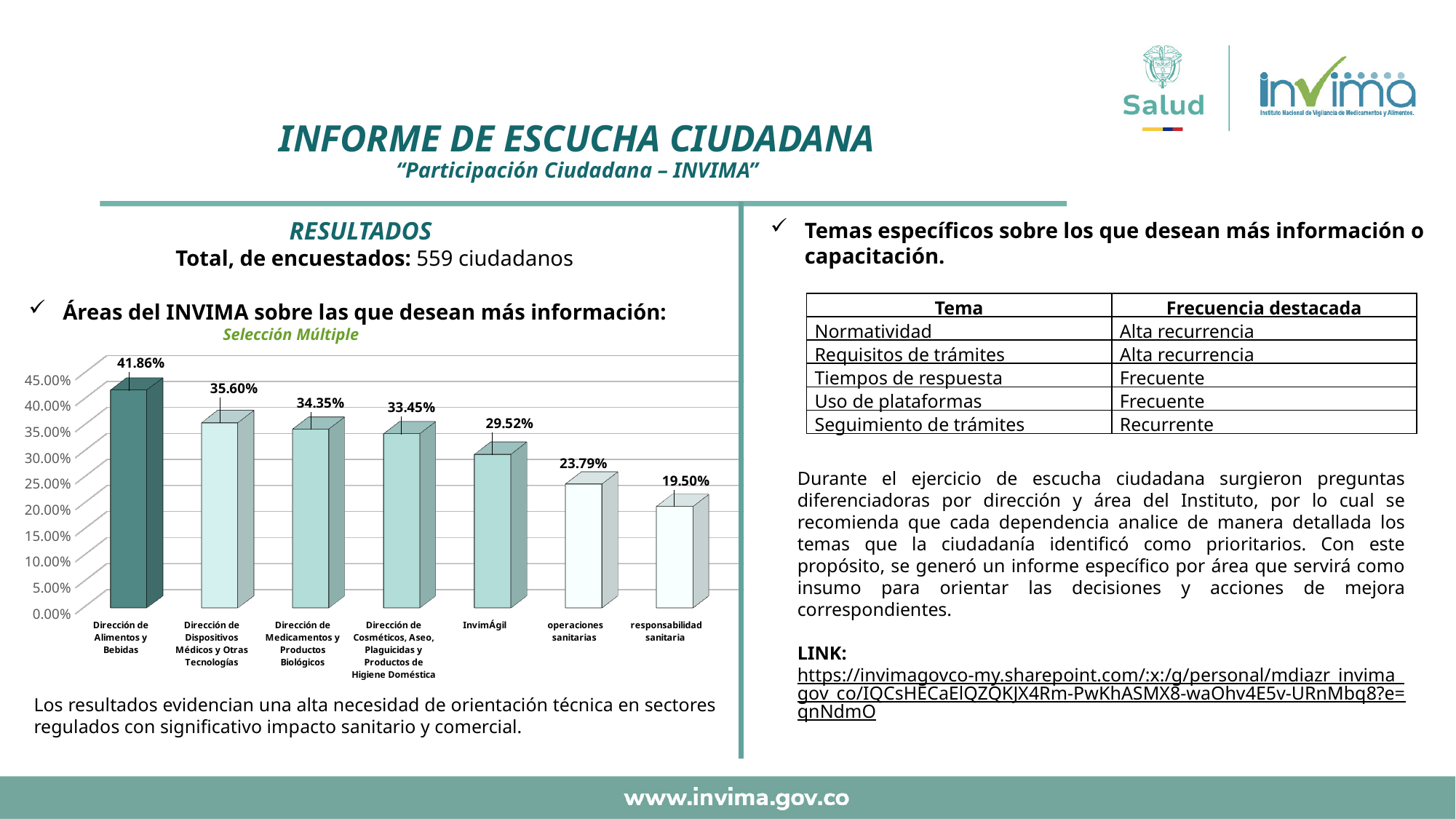
What is the value for operaciones sanitarias? 23.79% Do the values rise or fall from left to right along the x axis? Fall What is the value for Dirección de Cosméticos, Aseo, Plaguicidas y Productos de Higiene Doméstica? 33.45% Which category has the lowest value? responsabilidad sanitaria What kind of chart is shown on the slide? Bar chart What is the value for InvimÁgil? 29.52% Which category has the highest value? Dirección de Alimentos y Bebidas What is the value for Dirección de Alimentos y Bebidas? 41.86% How many categories are shown in the chart? 7 What is the difference between the values for InvimÁgil and operaciones sanitarias? 5.73% What is the difference between the values for Dirección de Alimentos y Bebidas and responsabilidad sanitaria? 22.36% Which is larger, the value for Dirección de Dispositivos Médicos y Otras Tecnologías or the value for Dirección de Medicamentos y Productos Biológicos? Dirección de Dispositivos Médicos y Otras Tecnologías